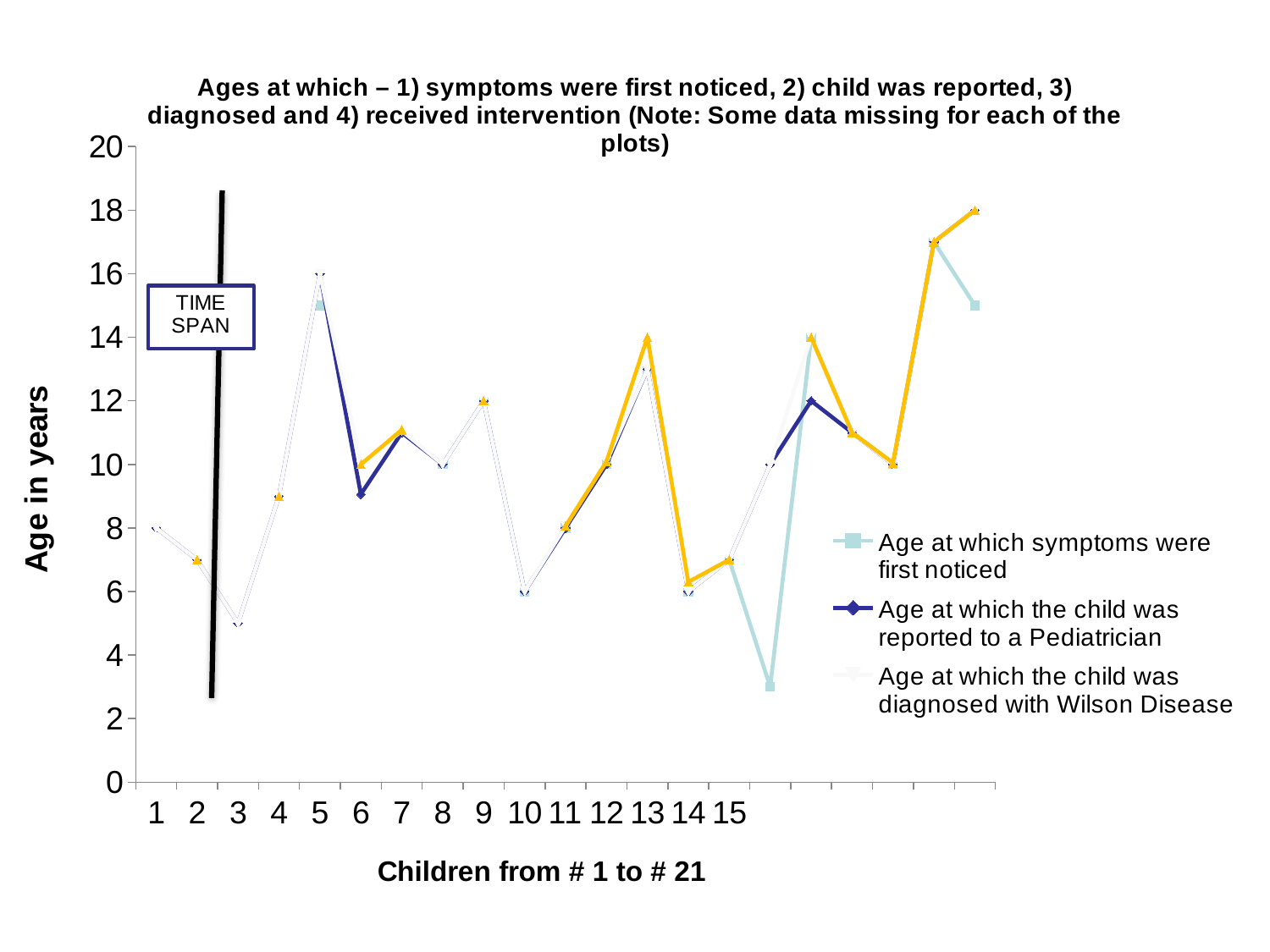
Is the age at which symptoms were first noticed for child 5 greater or less than 14? greater Which child has the higher plotted age, child 5 or child 6? child 5 Is the age at which child 6 was reported to a Pediatrician greater or less than 10? less Is the age plotted for child 10 greater or less than 8? less How many series does the legend list? 3 What age is plotted for child 9? 12 Do the plotted ages rise or fall from child 10 to child 13? rise What kind of chart is shown on the slide? line chart What is the title of the vertical axis? Age in years What age is plotted for child 1? 8 What is the title of the horizontal axis? Children from # 1 to # 21